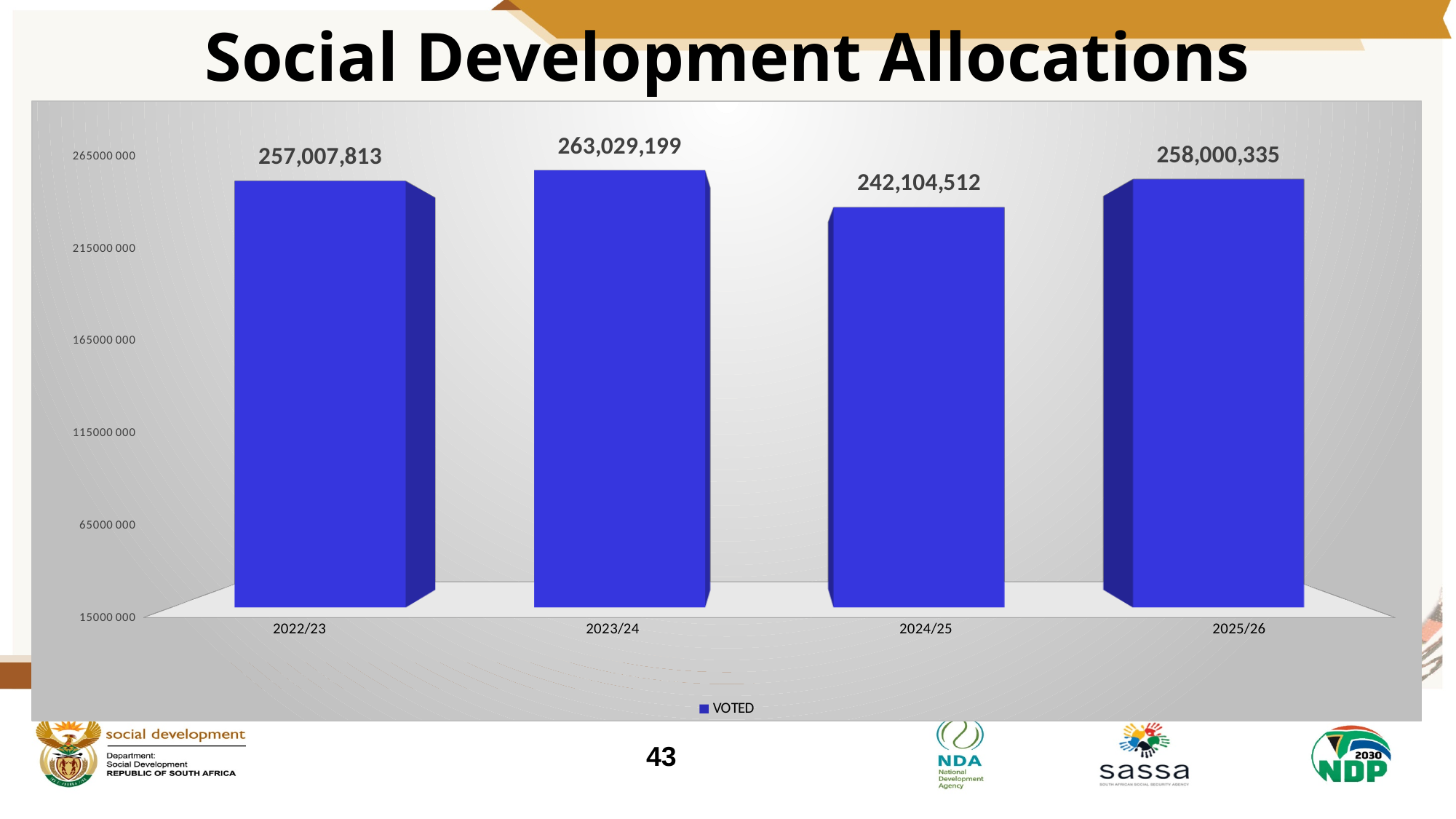
What is the value for 2022/23? 257,007,813 What series name does the legend show? VOTED What is the value for 2024/25? 242,104,512 How many years are shown on the x axis? 4 What kind of chart is shown on the slide? bar chart Is the value for 2024/25 greater or less than 215000 000? greater Which year has the highest allocation? 2023/24 What is the difference between the values for 2025/26 and 2024/25? 15,895,823 Which year has the lowest allocation? 2024/25 What is the difference between the values for 2023/24 and 2024/25? 20,924,687 Which is larger, the value for 2023/24 or the value for 2024/25? 2023/24 What is the value for 2025/26? 258,000,335